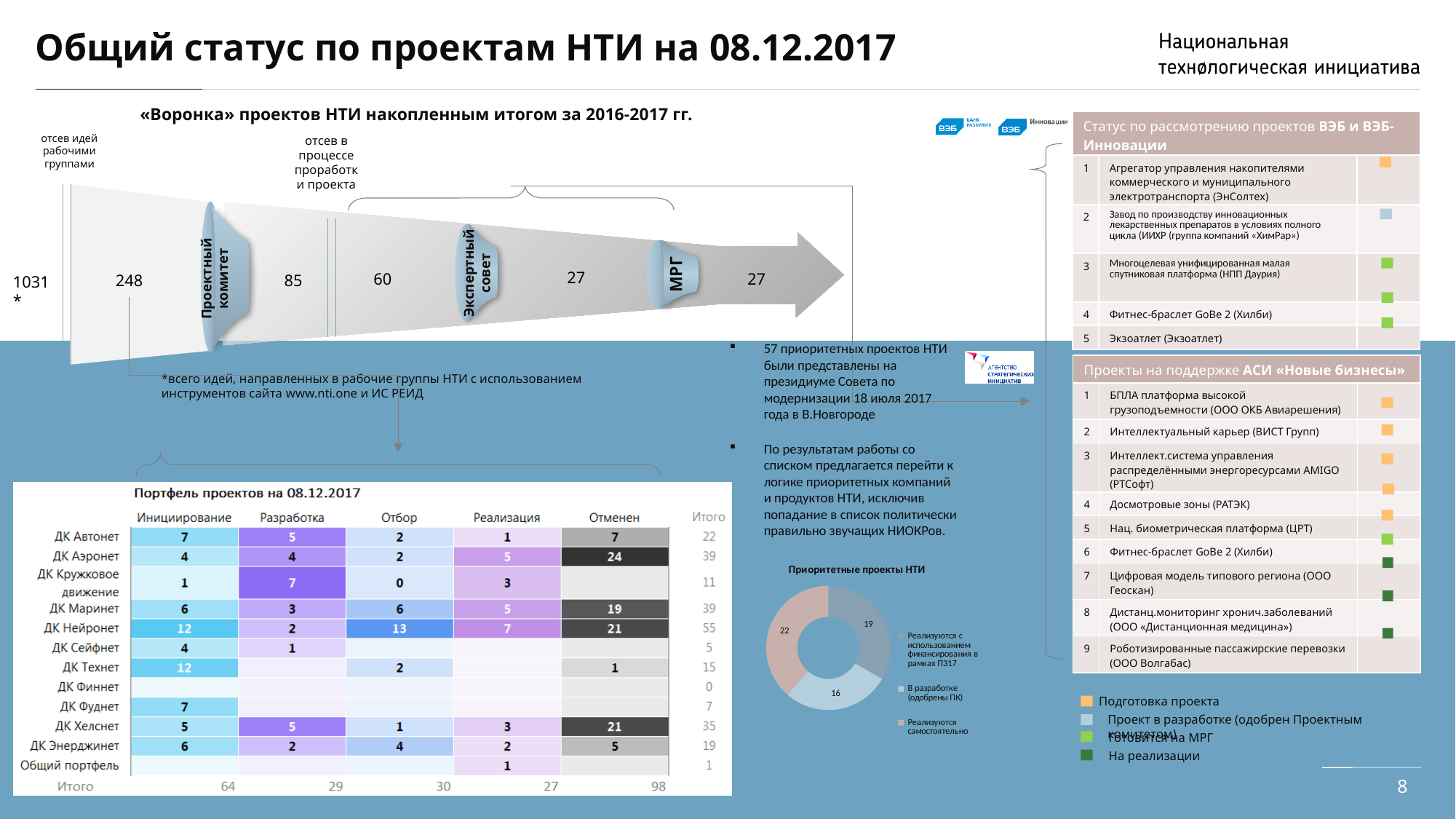
In the 'Приоритетные проекты НТИ' chart, which slice is the smallest? В разработке (одобрены ПК) In the 'Приоритетные проекты НТИ' chart, what is the value of the slice 'В разработке (одобрены ПК)'? 16 In the 'Приоритетные проекты НТИ' chart, what is the value of the slice 'Реализуются самостоятельно'? 22 In the funnel chart '«Воронка» проектов НТИ накопленным итогом за 2016-2017 гг.', what is the number shown after the 'Экспертный совет' stage? 27 In the 'Приоритетные проекты НТИ' chart, what is the total of all three slices? 57 In the 'Приоритетные проекты НТИ' chart, what is the difference between the 'Реализуются самостоятельно' slice and the 'В разработке (одобрены ПК)' slice? 6 In the 'Приоритетные проекты НТИ' chart, which slice is the largest? Реализуются самостоятельно In the 'Приоритетные проекты НТИ' chart, how many entries does the legend list? 3 In the 'Приоритетные проекты НТИ' chart, how many slices are there? 3 In the 'Приоритетные проекты НТИ' chart, which is larger: the slice for 'Реализуются с использованием финансирования в рамках ПЗ17' or the slice for 'В разработке (одобрены ПК)'? Реализуются с использованием финансирования в рамках ПЗ17 In the 'Приоритетные проекты НТИ' chart, what is the value of the slice 'Реализуются с использованием финансирования в рамках ПЗ17'? 19 What kind of chart is the 'Приоритетные проекты НТИ' chart? Donut (pie) chart